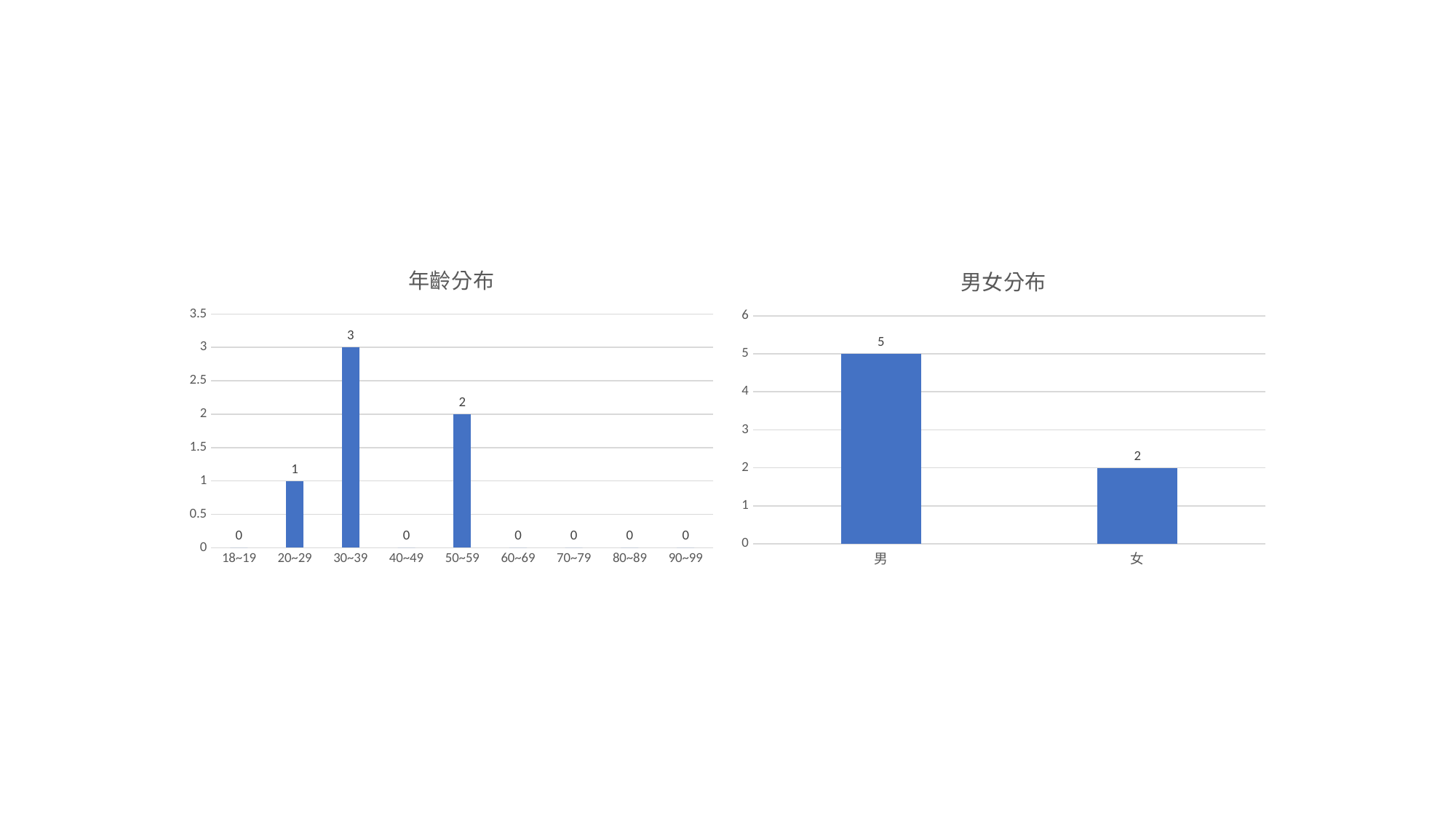
In the 男女分布 chart, what is the value for 男? 5 In the 年齢分布 chart, how many age groups have a value of 0? 6 In the 男女分布 chart, what is the difference between the values for 男 and 女? 3 In the 男女分布 chart, which category is larger, 男 or 女? 男 What kind of chart is the 男女分布 chart? Bar chart In the 年齢分布 chart, what is the value for 20~29? 1 In the 年齢分布 chart, which age group has the highest value? 30~39 In the 年齢分布 chart, how many age categories are shown on the x axis? 9 In the 年齢分布 chart, what is the value for 50~59? 2 In the 年齢分布 chart, what is the difference between the values for 30~39 and 50~59? 1 In the 年齢分布 chart, what is the value for 30~39? 3 In the 男女分布 chart, what is the value for 女? 2